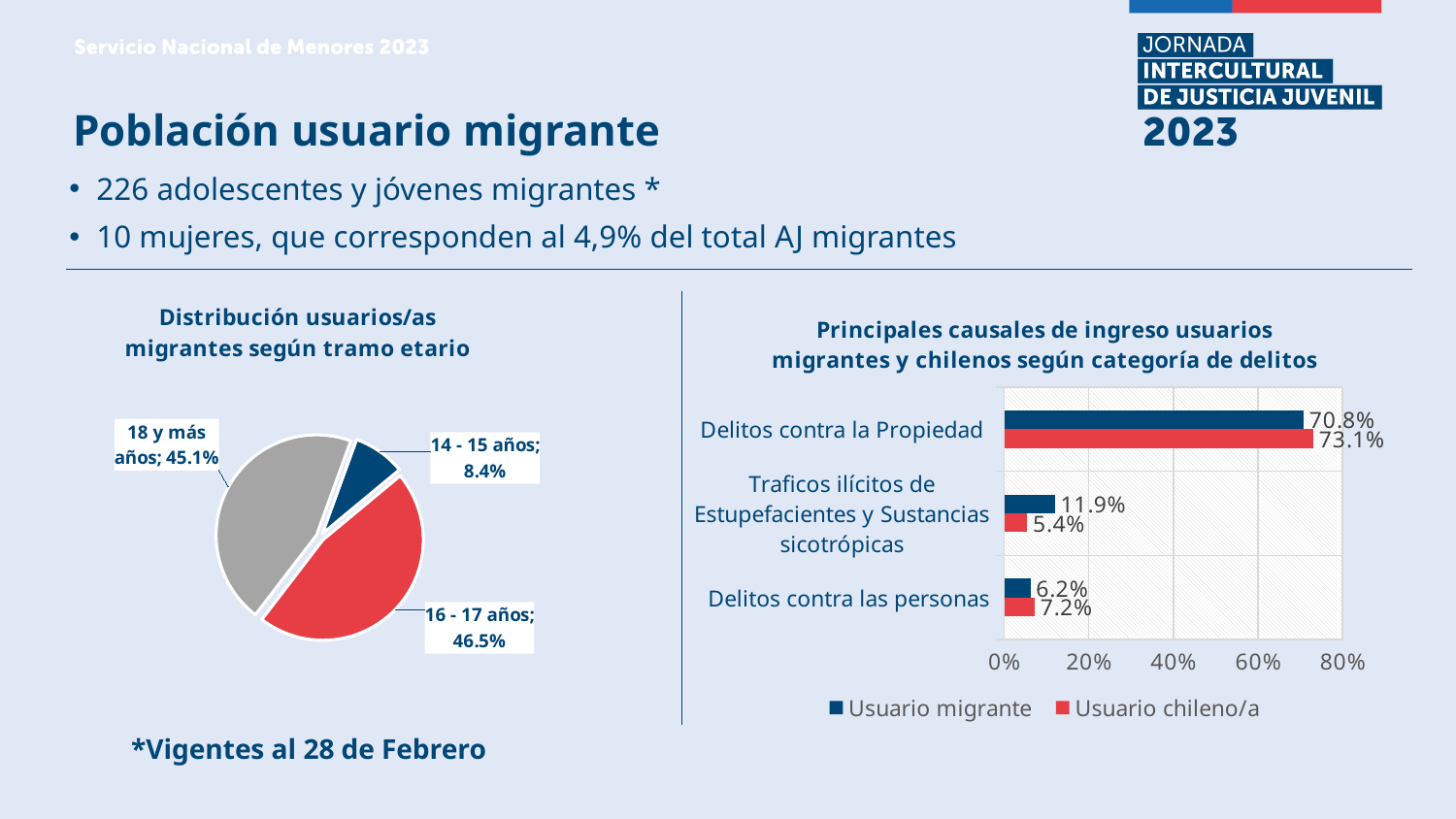
In the bar chart 'Principales causales de ingreso usuarios migrantes y chilenos según categoría de delitos', which category has the highest value for 'Usuario chileno/a'? Delitos contra la Propiedad In the pie chart 'Distribución usuarios/as migrantes según tramo etario', what share corresponds to '16 - 17 años'? 46.5% In the pie chart 'Distribución usuarios/as migrantes según tramo etario', how many slices are there? 3 In the pie chart 'Distribución usuarios/as migrantes según tramo etario', what is the difference between the shares of '16 - 17 años' and '18 y más años'? 1.4% In the bar chart 'Principales causales de ingreso usuarios migrantes y chilenos según categoría de delitos', how many series does the legend list? 2 In the bar chart 'Principales causales de ingreso usuarios migrantes y chilenos según categoría de delitos', which is larger for 'Delitos contra las personas': 'Usuario migrante' or 'Usuario chileno/a'? Usuario chileno/a In the bar chart 'Principales causales de ingreso usuarios migrantes y chilenos según categoría de delitos', what is the value for 'Usuario migrante' in 'Delitos contra la Propiedad'? 70.8% In the pie chart 'Distribución usuarios/as migrantes según tramo etario', what share corresponds to '14 - 15 años'? 8.4% In the bar chart 'Principales causales de ingreso usuarios migrantes y chilenos según categoría de delitos', what is the value for 'Usuario chileno/a' in 'Traficos ilícitos de Estupefacientes y Sustancias sicotrópicas'? 5.4% In the pie chart 'Distribución usuarios/as migrantes según tramo etario', which age group has the smallest share? 14 - 15 años What type of chart is 'Principales causales de ingreso usuarios migrantes y chilenos según categoría de delitos'? Bar chart In the bar chart 'Principales causales de ingreso usuarios migrantes y chilenos según categoría de delitos', what is the difference between 'Usuario migrante' and 'Usuario chileno/a' in 'Traficos ilícitos de Estupefacientes y Sustancias sicotrópicas'? 6.5%